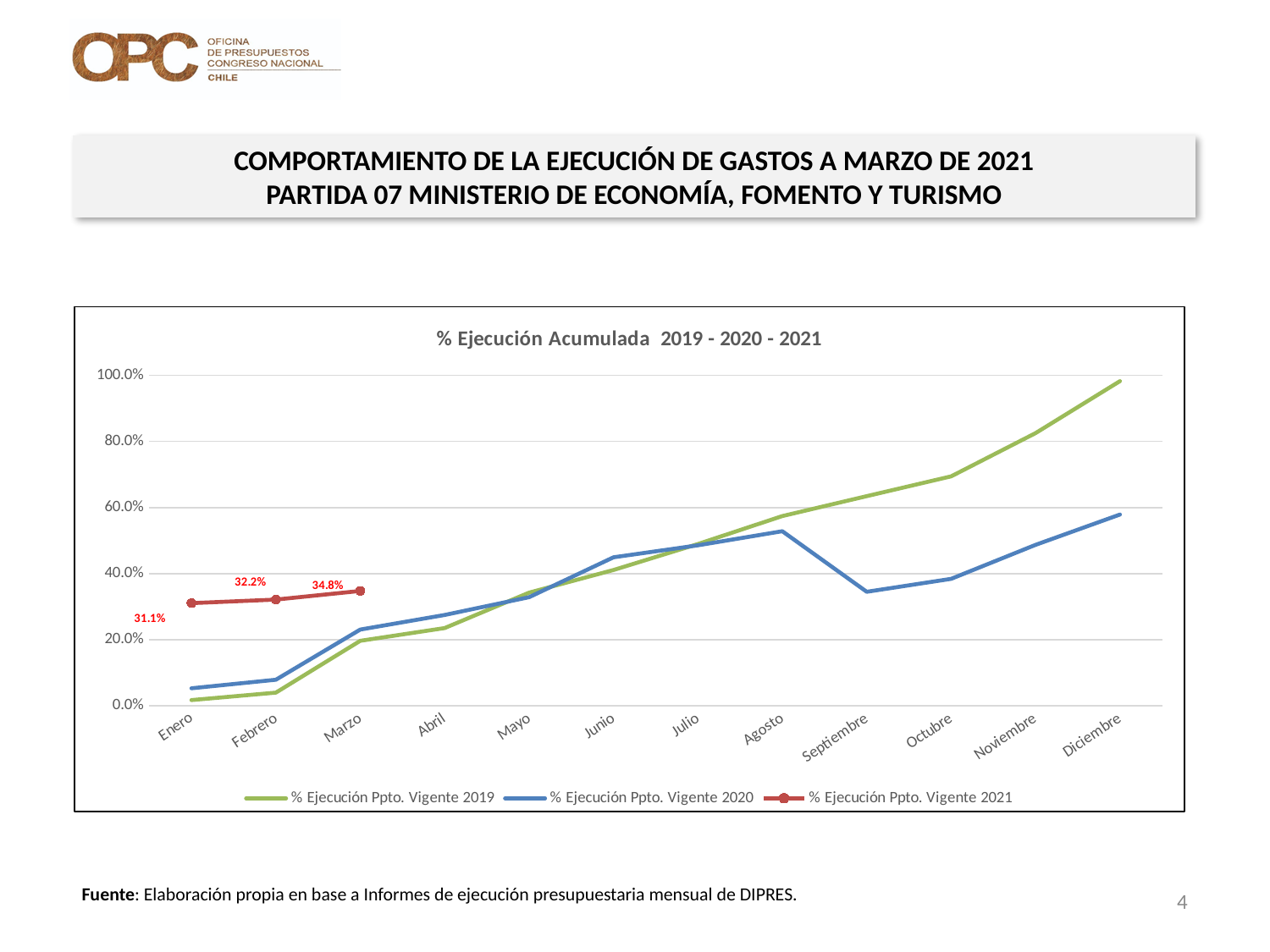
What is the title of the chart? % Ejecución Acumulada 2019 - 2020 - 2021 What is the value for Febrero in the % Ejecución Ppto. Vigente 2021 series? 32.2% How many months are shown on the x axis? 12 What is the value for Enero in the % Ejecución Ppto. Vigente 2021 series? 31.1% In Diciembre, which series is larger: % Ejecución Ppto. Vigente 2019 or % Ejecución Ppto. Vigente 2020? % Ejecución Ppto. Vigente 2019 Is the Diciembre value for % Ejecución Ppto. Vigente 2019 greater or less than 80.0%? greater What kind of chart is shown? Line chart Is the Septiembre value for % Ejecución Ppto. Vigente 2020 greater or less than 40.0%? less What is the value for Marzo in the % Ejecución Ppto. Vigente 2021 series? 34.8% What is the difference between the Marzo and Enero values of the % Ejecución Ppto. Vigente 2021 series? 3.7% Which month has the highest value in the % Ejecución Ppto. Vigente 2021 series? Marzo How many series does the legend list? 3